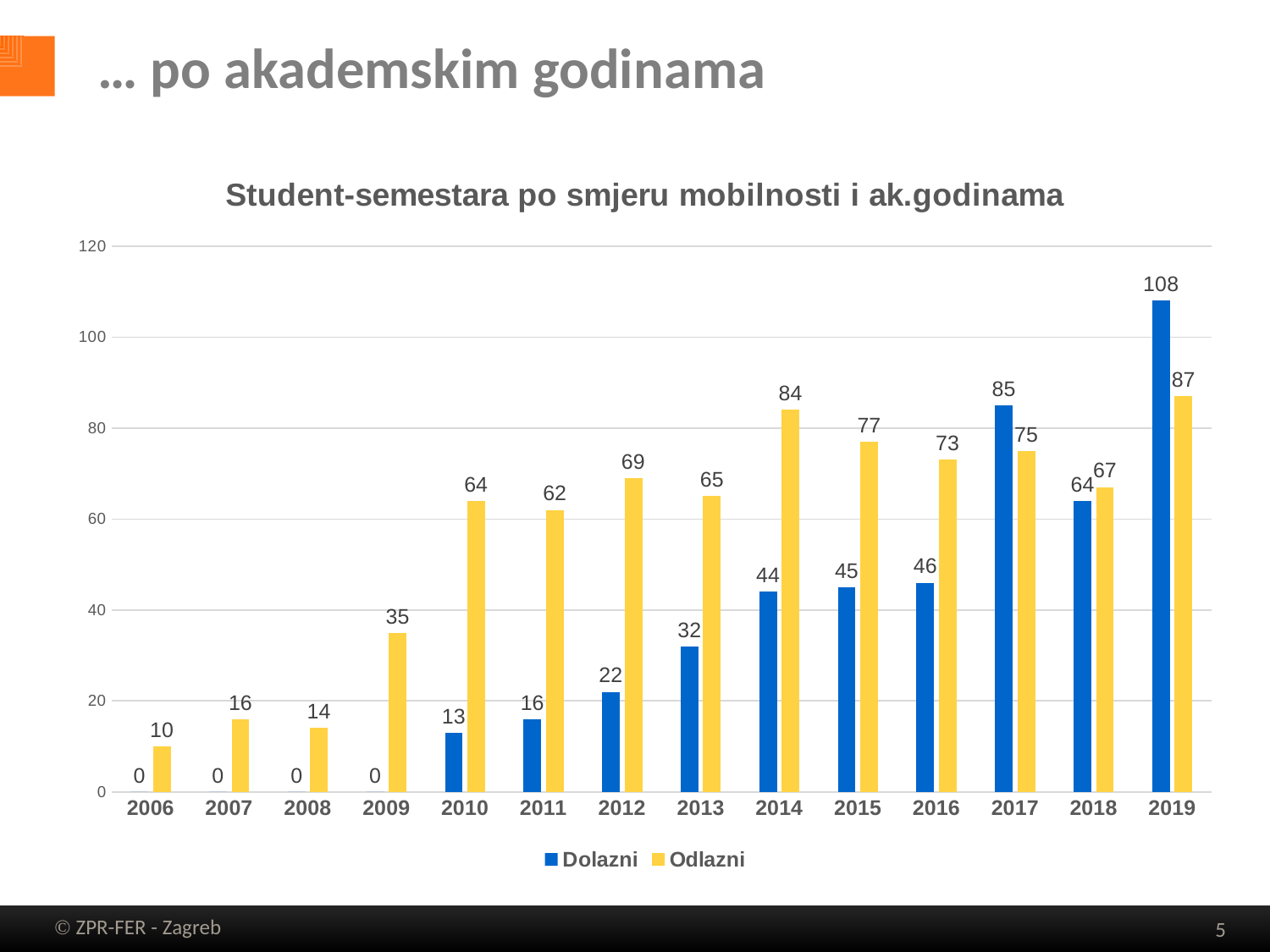
Which year has the lowest Odlazni value? 2006 How many series does the legend list? 2 What is the Dolazni value for 2013? 32 What is the Dolazni value for 2019? 108 How many years are shown on the x axis? 14 What is the title of the chart? Student-semestara po smjeru mobilnosti i ak.godinama What is the Odlazni value for 2014? 84 Is the Odlazni value for 2015 greater or less than 60? greater Which year has the highest Odlazni value? 2019 What is the difference between the Odlazni and Dolazni values in 2014? 40 What kind of chart is shown? bar chart Which is larger in 2017, Dolazni or Odlazni? Dolazni